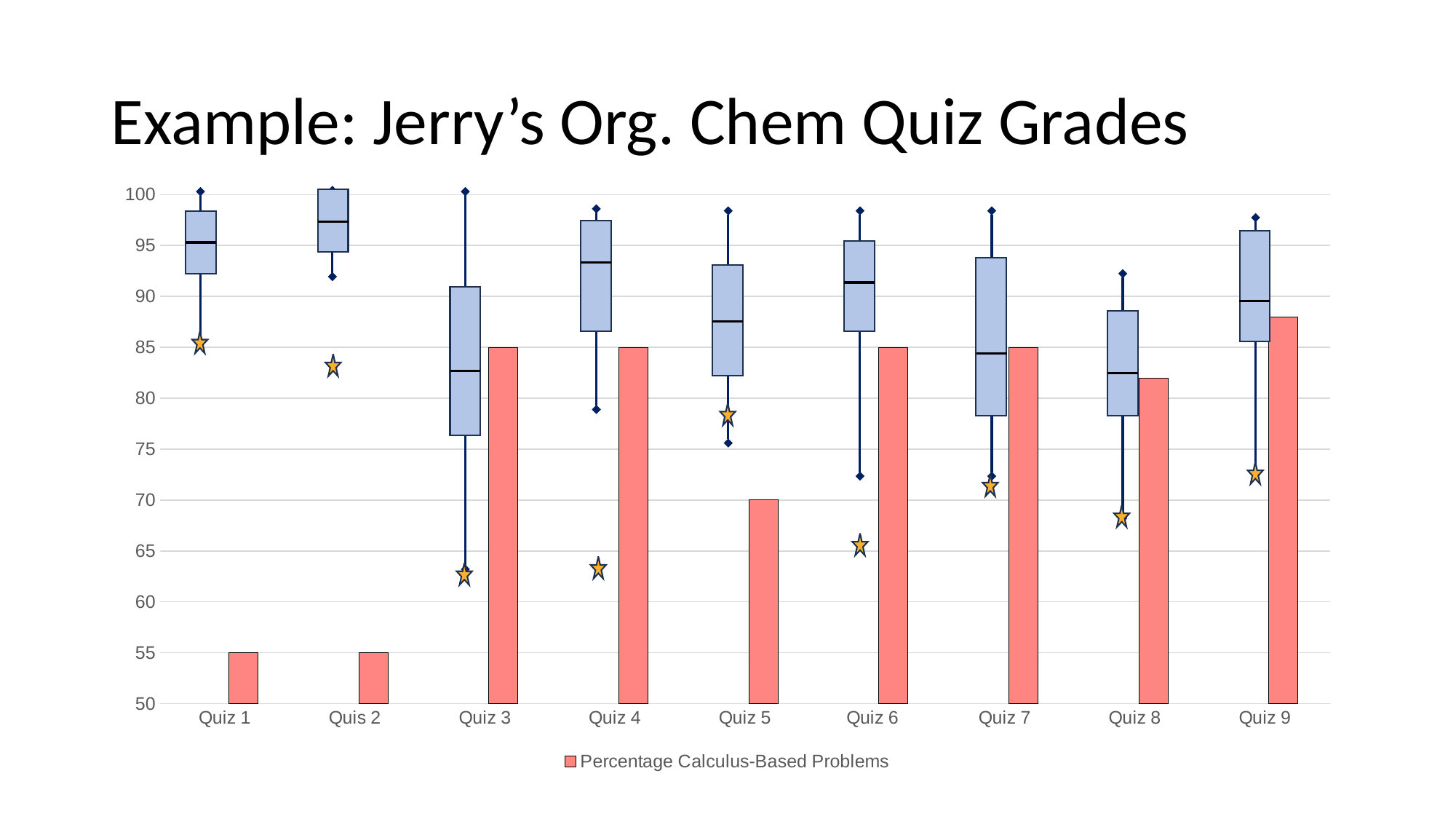
Which quiz has the highest Percentage Calculus-Based Problems bar? Quiz 9 Which has a larger Percentage Calculus-Based Problems bar, Quiz 5 or Quiz 6? Quiz 6 What is the value of the Percentage Calculus-Based Problems bar for Quiz 5? 70 Which quizzes have the lowest Percentage Calculus-Based Problems bar? Quiz 1 and Quis 2 What is the value of the Percentage Calculus-Based Problems bar for Quiz 1? 55 What is the difference between the Percentage Calculus-Based Problems bars for Quiz 3 and Quiz 1? 30 What is the value of the Percentage Calculus-Based Problems bar for Quiz 3? 85 Is the Percentage Calculus-Based Problems bar for Quiz 8 greater or less than 80? greater Is the Percentage Calculus-Based Problems bar for Quiz 9 greater or less than 90? less How many series does the chart legend list? 1 What is the name of the series shown in the chart legend? Percentage Calculus-Based Problems How many quizzes are shown on the x axis of the chart? 9